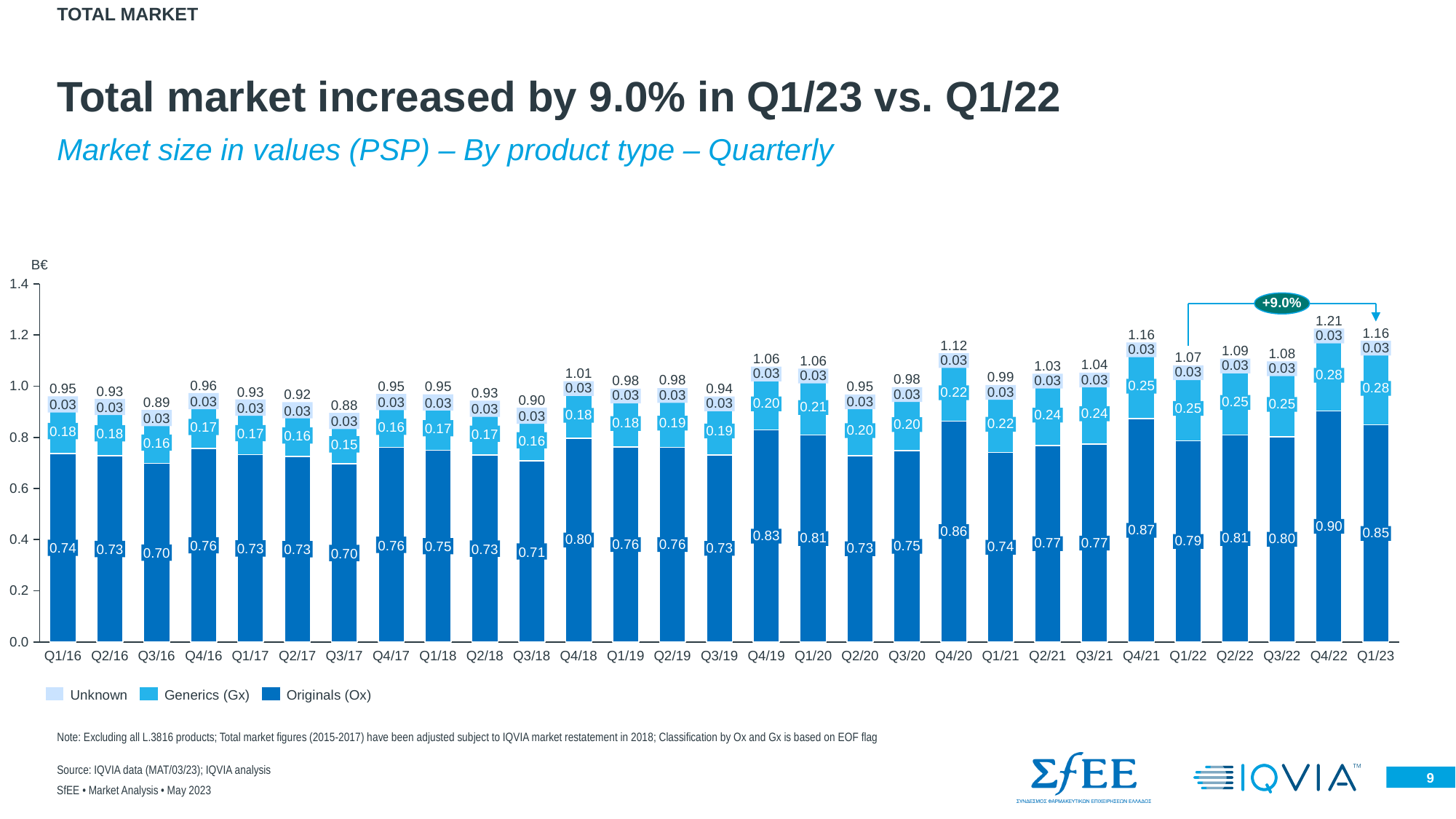
Which is larger, the Generics (Gx) value for Q4/21 or for Q4/18? Q4/21 Which quarter has the lowest total market value? Q3/17 What is the Unknown value for Q2/20? 0.03 What percentage change is shown in the callout between Q1/22 and Q1/23? +9.0% What is the Generics (Gx) value for Q3/17? 0.15 What is the difference between the total market values for Q1/23 and Q1/22? 0.09 What kind of chart is shown on the slide? Stacked bar chart How many quarters are shown on the x axis? 29 How many series does the legend list? 3 What is the Originals (Ox) value for Q4/22? 0.90 What is the total market value shown above the bar for Q1/23? 1.16 Which quarter has the highest total market value? Q4/22